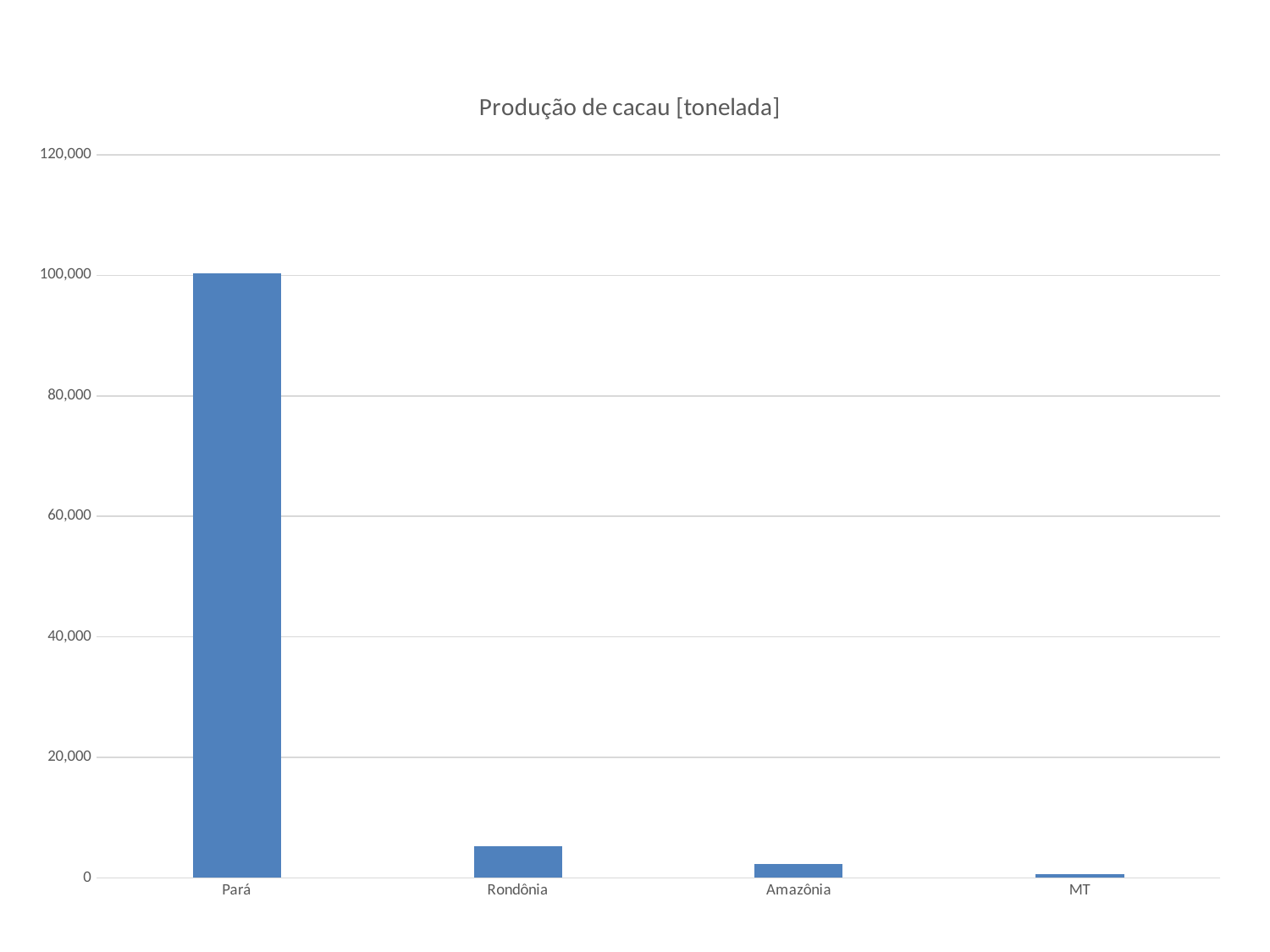
Is the value for Rondônia greater or less than 20,000? less Is the value for Amazônia greater or less than 20,000? less What is the title of the chart? Produção de cacau [tonelada] Which category has the highest cocoa production? Pará Is the value for Pará greater or less than 80,000? greater What type of chart is shown on the slide? bar chart Do the values rise or fall moving from left to right along the x axis? fall Which category has the lowest cocoa production? MT How many categories are shown on the x axis? 4 Which has a larger value, Amazônia or MT? Amazônia Which has a larger value, Rondônia or Amazônia? Rondônia